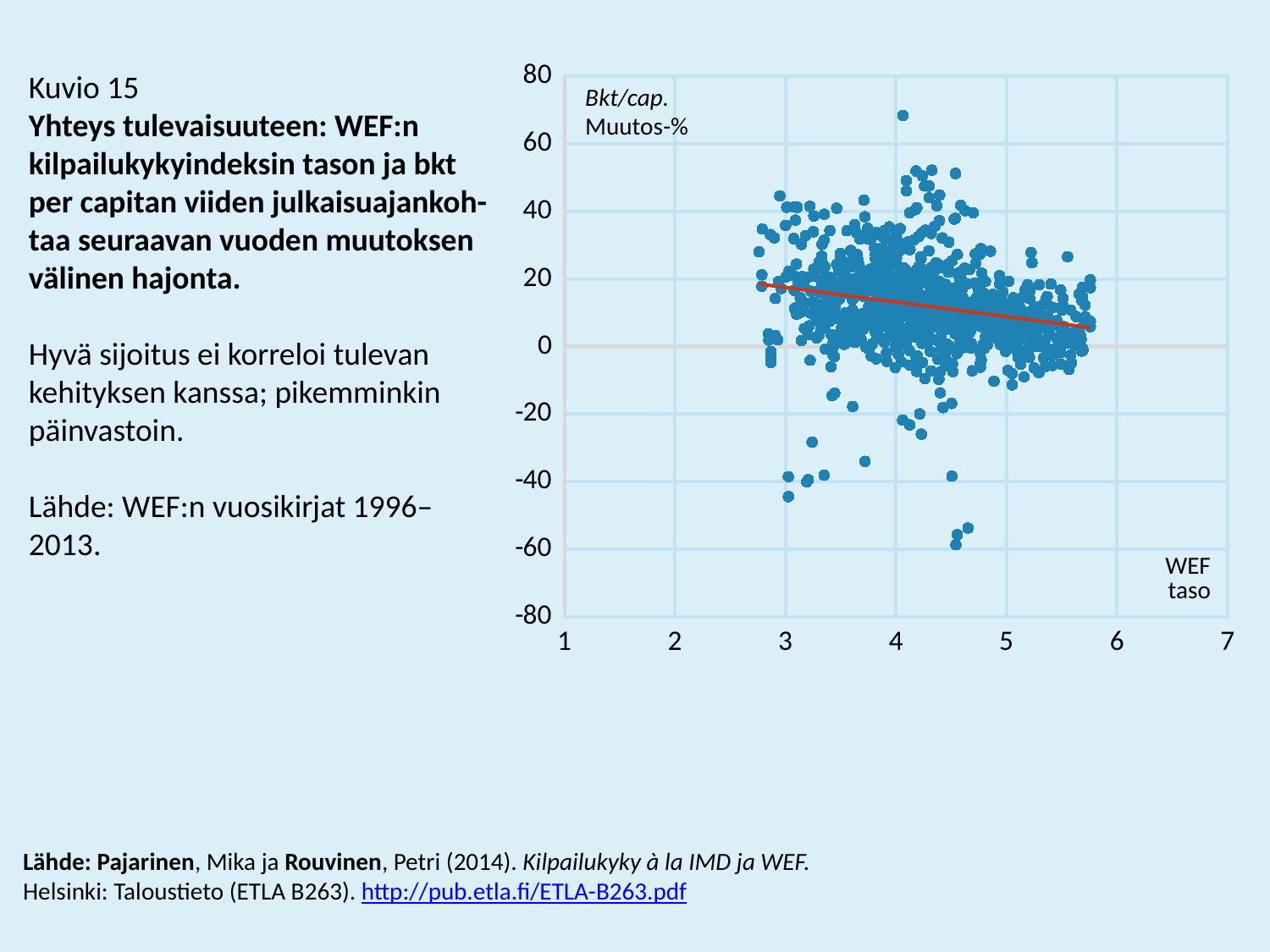
Is the smallest WEF taso value among the plotted points greater or less than 2? greater What kind of chart is shown on the slide? scatter chart Is the lowest point in the scatter greater or less than -40 on the y axis? less Is the largest WEF taso value among the plotted points greater or less than 6? less What is the label of the y axis? Bkt/cap. Muutos-% Does the red trend line rise or fall as the WEF taso increases along the x axis? falls What is the label of the x axis? WEF taso Is the red trend line higher at WEF taso 3 or at WEF taso 5.5? at WEF taso 3